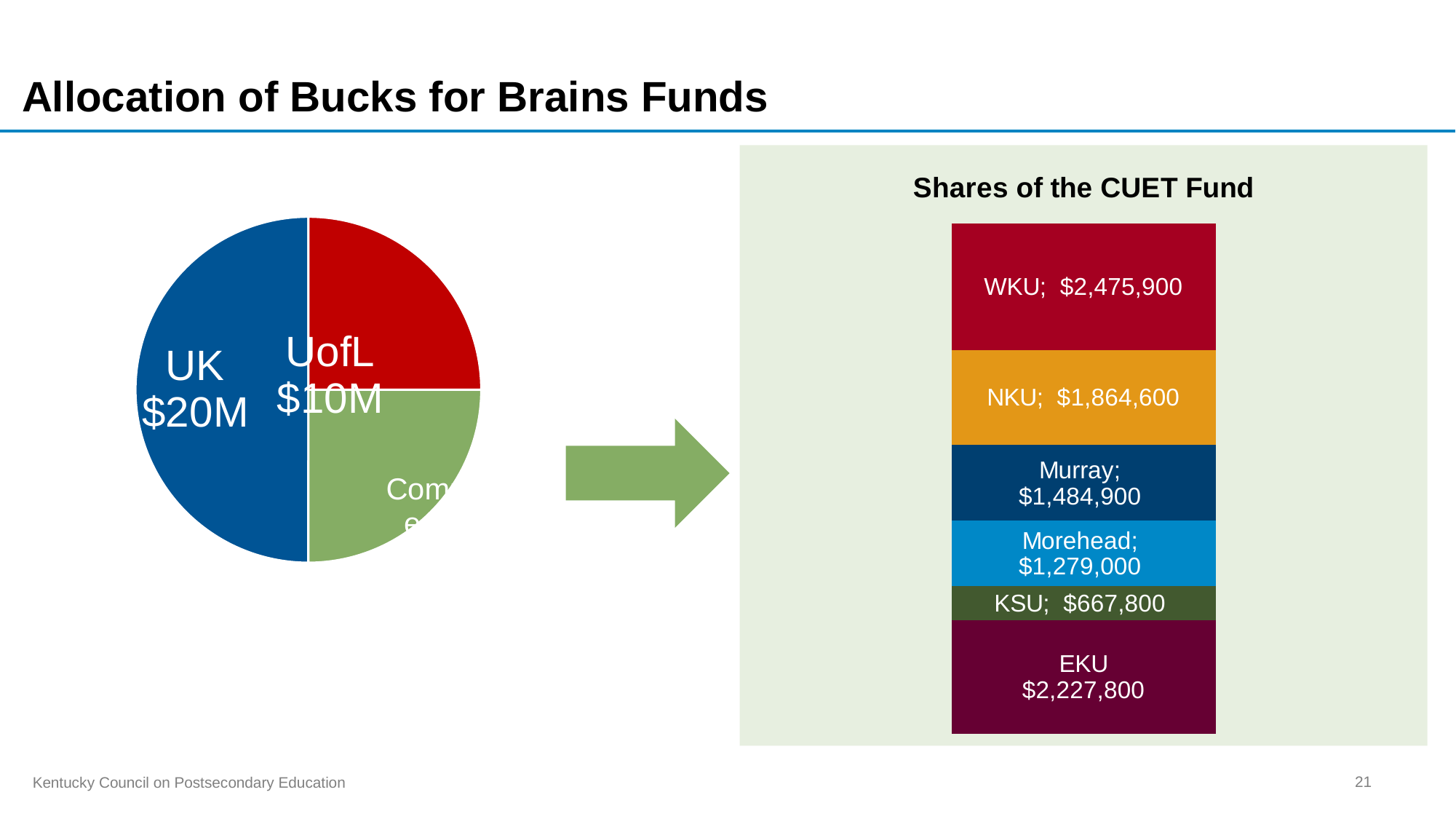
In the 'Shares of the CUET Fund' chart, which institution has the largest share? WKU How many institutions are shown in the 'Shares of the CUET Fund' chart? 6 In the 'Shares of the CUET Fund' chart, what is the value for Morehead? $1,279,000 In the pie chart on the left, which is larger, the UK slice or the UofL slice? UK In the pie chart on the left, what value is shown for UK? $20M In the 'Shares of the CUET Fund' chart, what is the total of all the segments in the stacked bar? $10,000,000 In the pie chart on the left, what is the difference between the UK value and the UofL value? $10M In the 'Shares of the CUET Fund' chart, what is the difference between the WKU and EKU values? $248,100 How many slices does the pie chart on the left have? 3 In the pie chart on the left, what value is shown for UofL? $10M In the 'Shares of the CUET Fund' chart, what is the value for WKU? $2,475,900 In the 'Shares of the CUET Fund' chart, which institution has the smallest share? KSU